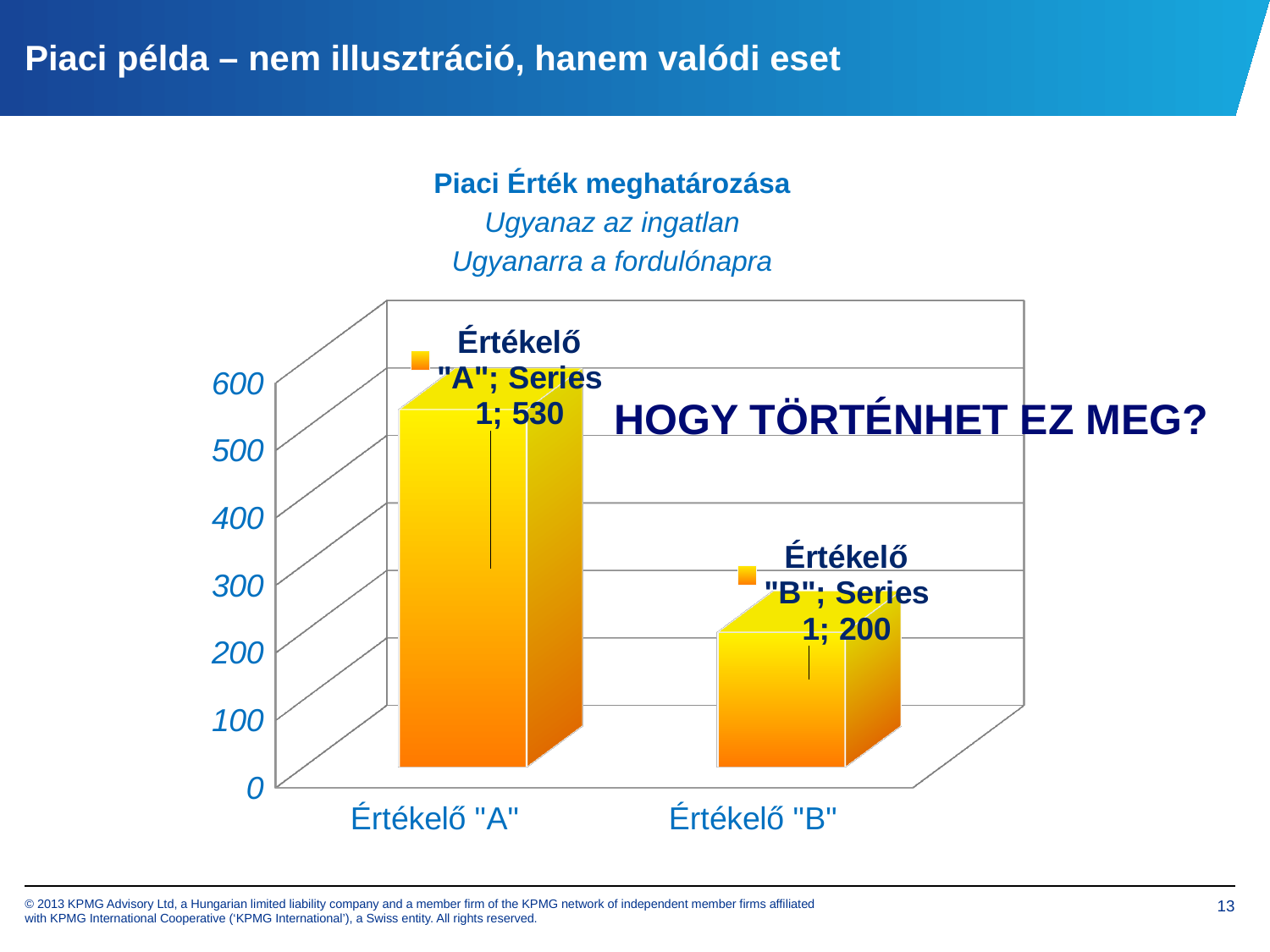
Which is larger, the value for Értékelő "A" or Értékelő "B"? Értékelő "A" Is the value for Értékelő "A" greater or less than 500? greater What kind of chart is shown on the slide? bar chart Do the values rise or fall from Értékelő "A" to Értékelő "B"? fall How many categories are shown on the x axis? 2 Which category has the lowest value? Értékelő "B" Which category has the highest value? Értékelő "A" What is the value for Értékelő "A"? 530 What is the title of the chart? Piaci Érték meghatározása What is the value for Értékelő "B"? 200 Is the value for Értékelő "B" greater or less than 300? less What is the difference between the values for Értékelő "A" and Értékelő "B"? 330